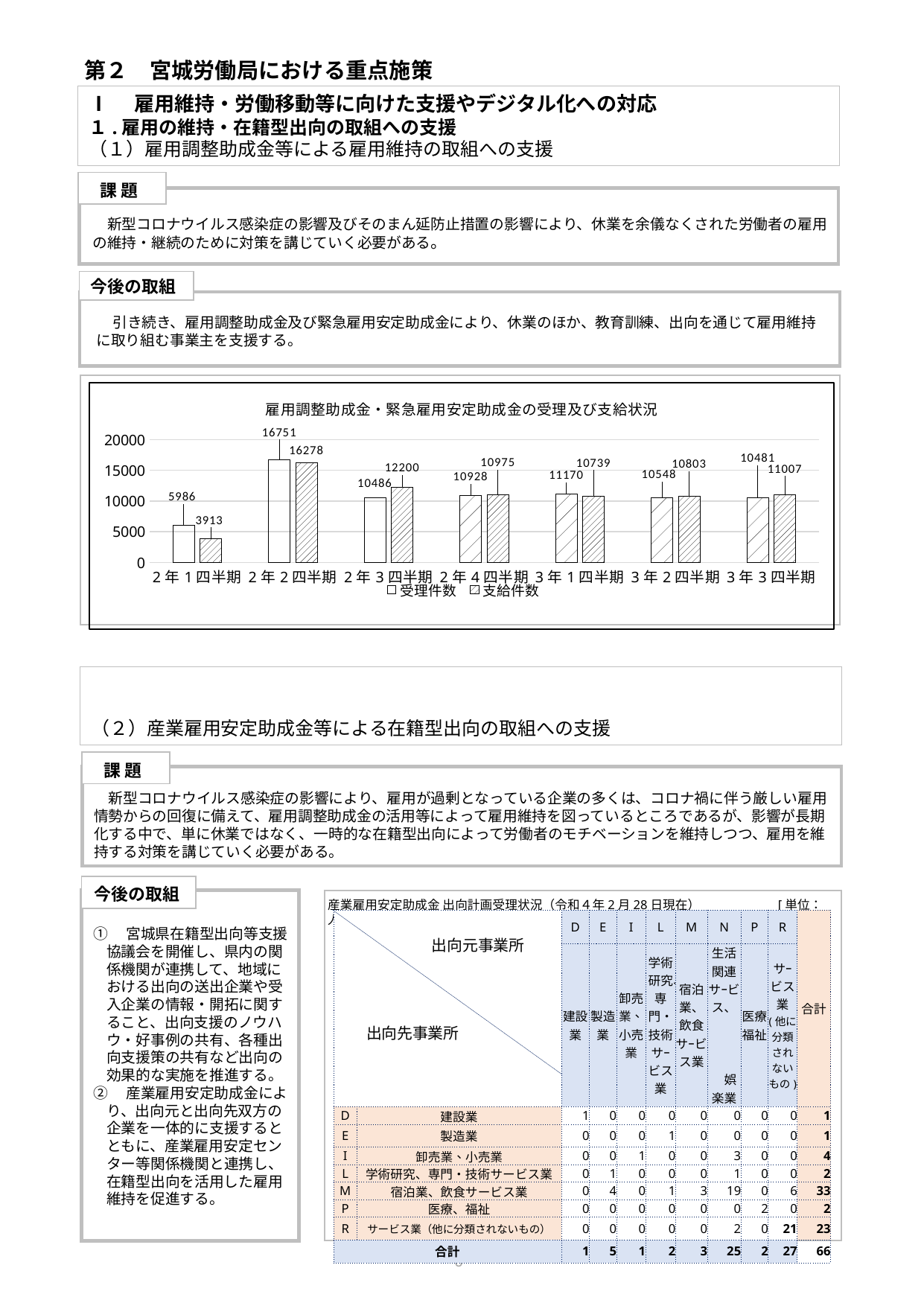
What is the 受理件数 value for 2年2四半期? 16751 For 2年3四半期, which is larger: 受理件数 or 支給件数? 支給件数 What is the 支給件数 value for 2年1四半期? 3913 Which quarter has the lowest 支給件数? 2年1四半期 What is the 支給件数 value for 3年3四半期? 11007 What is the difference between 受理件数 and 支給件数 for 2年1四半期? 2073 How many series does the chart's legend list? 2 What is the 受理件数 value for 3年1四半期? 11170 What kind of chart is shown on the slide? Bar chart What is the title of the chart? 雇用調整助成金・緊急雇用安定助成金の受理及び支給状況 How many quarters are shown on the x axis of the chart? 7 Which quarter has the highest 受理件数? 2年2四半期